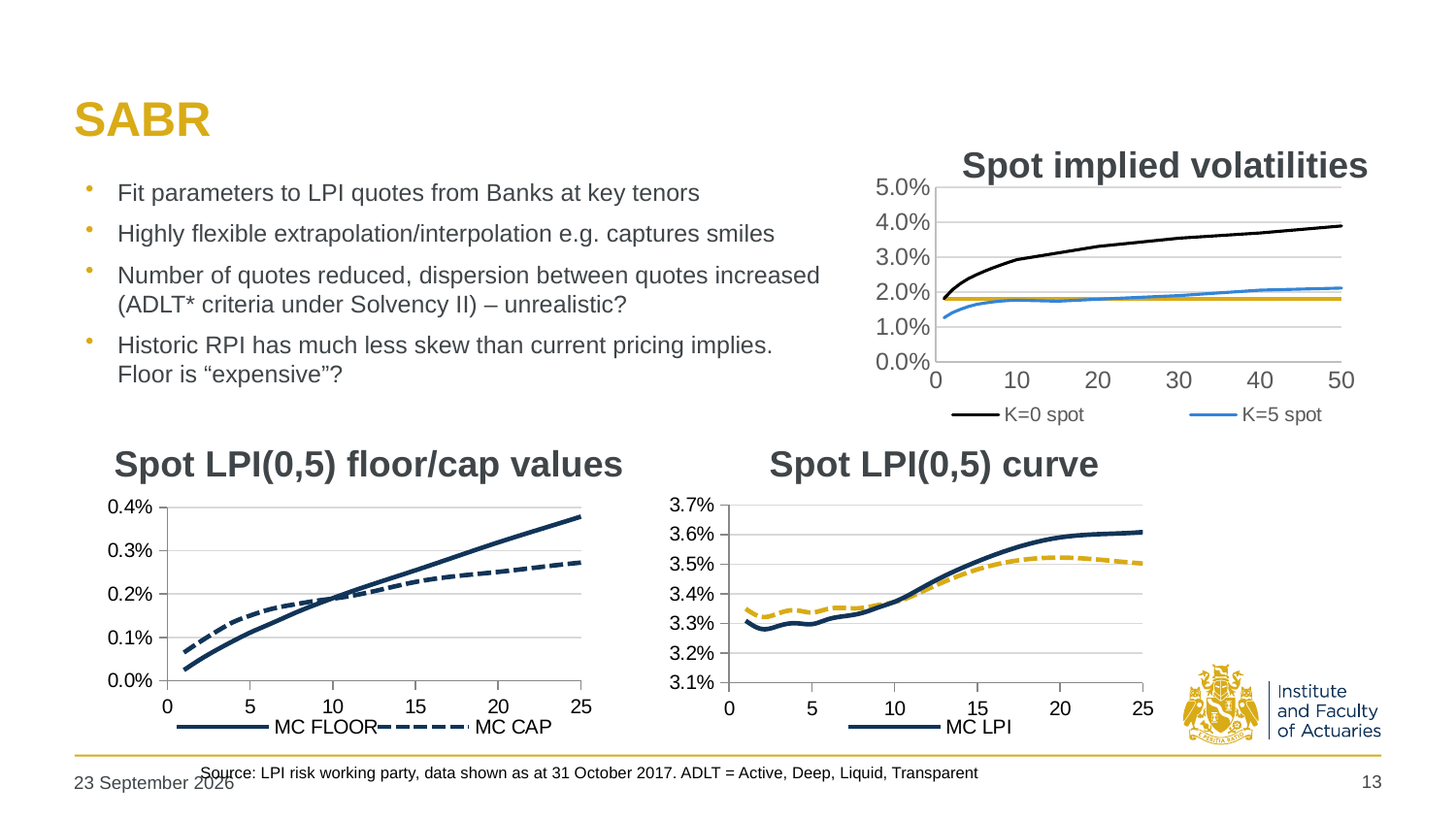
In the 'Spot implied volatilities' chart, which series is higher at x=50, K=0 spot or K=5 spot? K=0 spot In the 'Spot LPI(0,5) floor/cap values' chart, which series is higher at x=25, MC FLOOR or MC CAP? MC FLOOR In the 'Spot LPI(0,5) floor/cap values' chart, which series is higher at x=5, MC FLOOR or MC CAP? MC CAP How many series does the legend of the 'Spot LPI(0,5) curve' chart list? 1 In the 'Spot implied volatilities' chart, is the value of K=0 spot at x=50 greater or less than 3.0%? greater What are the two legend entries of the 'Spot LPI(0,5) floor/cap values' chart? MC FLOOR and MC CAP In the 'Spot implied volatilities' chart, does the K=0 spot line rise or fall as the x axis increases? rise In the 'Spot LPI(0,5) floor/cap values' chart, is the value of MC FLOOR at x=25 greater or less than 0.3%? greater In the 'Spot implied volatilities' chart, is the value of K=5 spot at x=50 greater or less than 3.0%? less What type of chart is the 'Spot implied volatilities' chart? line chart How many series does the legend of the 'Spot implied volatilities' chart list? 2